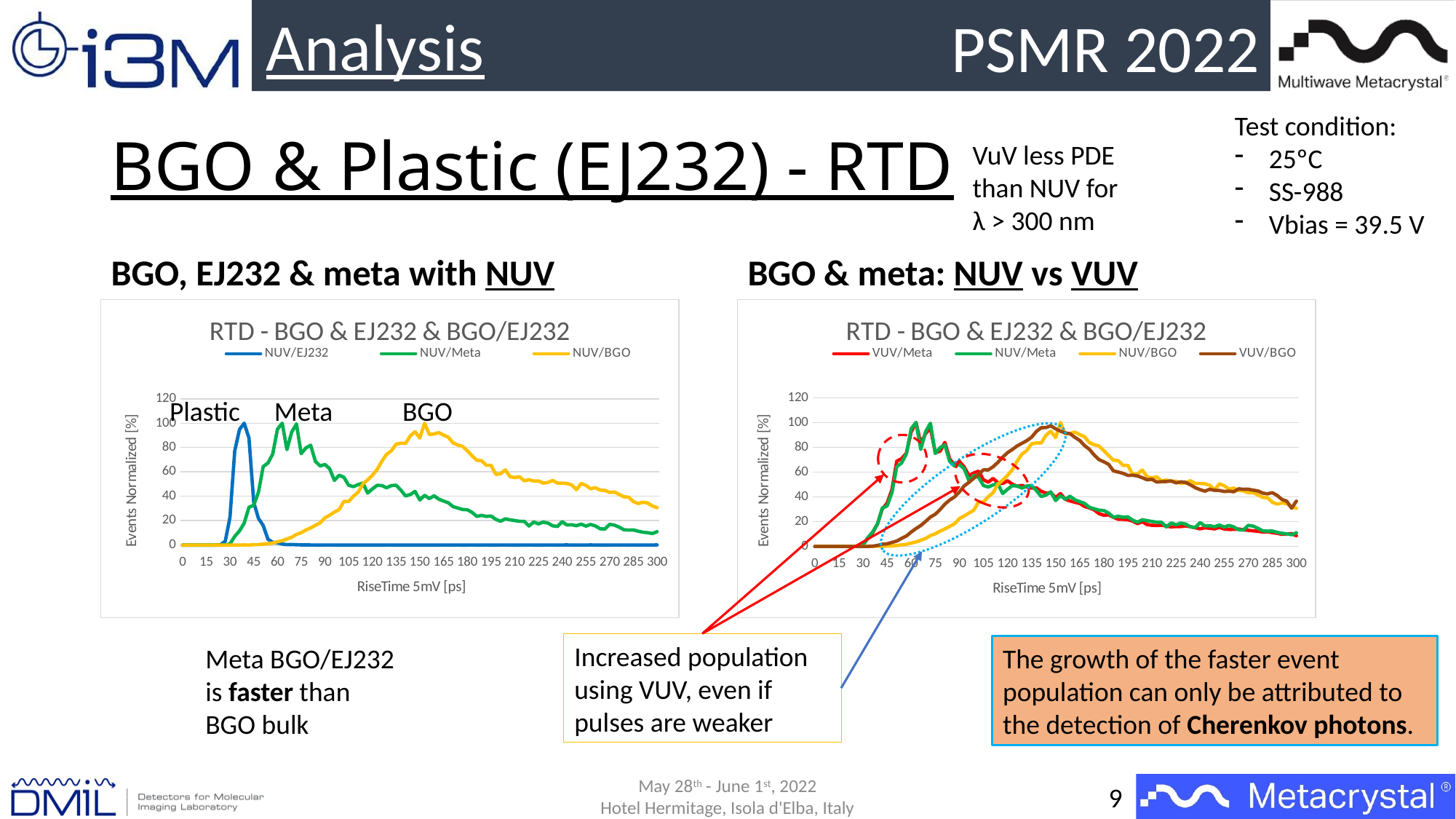
In the left chart, is the value of NUV/Meta at 150 ps greater or less than 60? less In the right chart, which is larger at 300 ps: VUV/BGO or VUV/Meta? VUV/BGO In the left chart, which series reaches its peak at the largest rise time? NUV/BGO What is the x-axis title of the right chart? RiseTime 5mV [ps] How many series does the legend of the left chart list? 3 In the left chart, which series reaches its peak at the smallest rise time? NUV/EJ232 In the left chart, is the value of NUV/EJ232 at 150 ps greater or less than 20? less In the right chart, is the value of VUV/Meta at 300 ps greater or less than 20? less How many series does the legend of the right chart list? 4 What kind of chart is the left chart on the slide? line chart What is the title of the left chart? RTD - BGO & EJ232 & BGO/EJ232